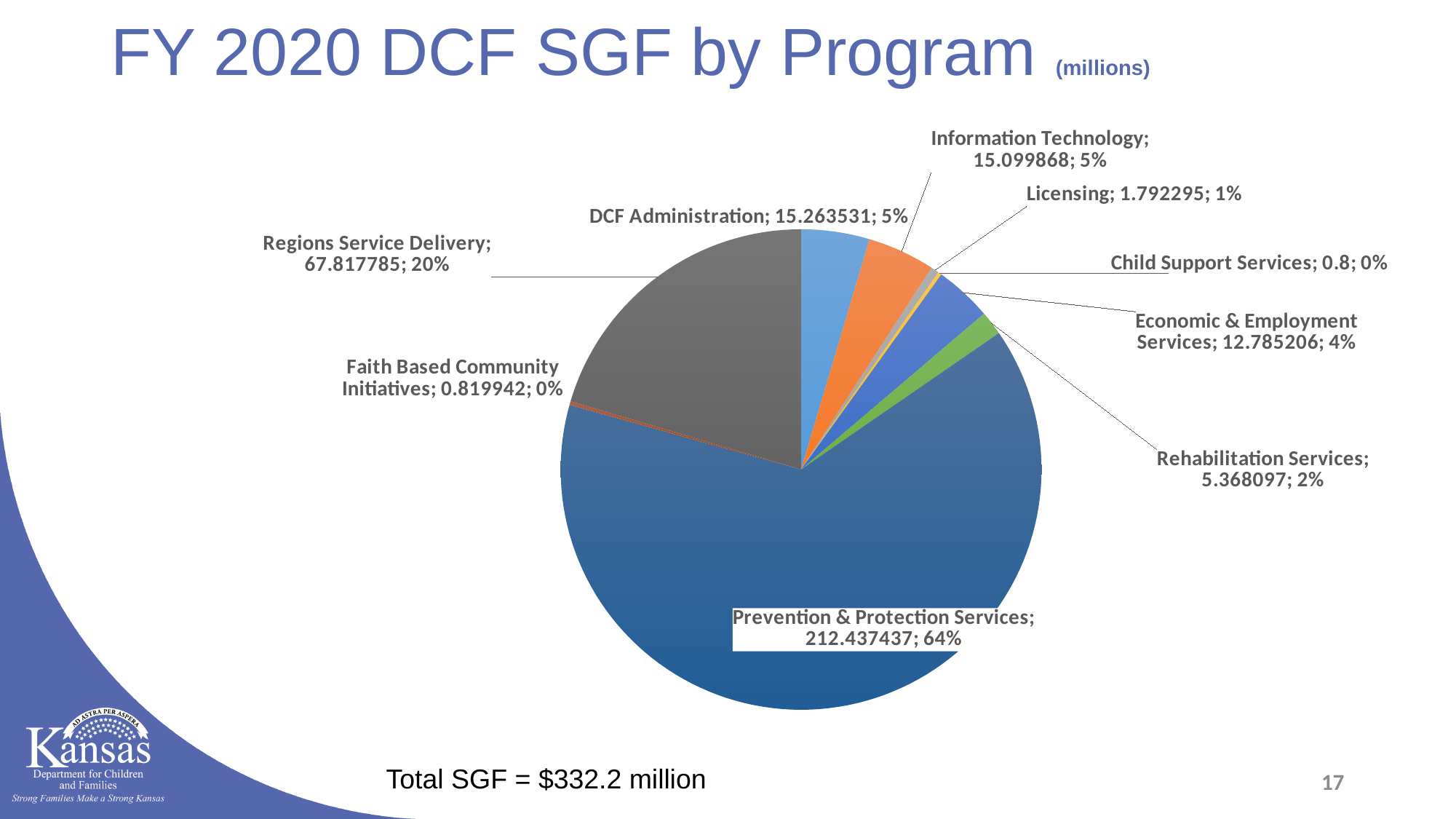
Which program has the largest slice of the pie? Prevention & Protection Services What is the value for Economic & Employment Services? 12.785206 Which is larger, the value for DCF Administration or the value for Information Technology? DCF Administration What is the difference between the values for Regions Service Delivery and Economic & Employment Services? 55.032579 What is the value for Licensing? 1.792295 What share of the pie does Rehabilitation Services represent? 2% What is the title of the chart on the slide? FY 2020 DCF SGF by Program (millions) How many programs are shown in the pie chart? 9 What is the value for Regions Service Delivery? 67.817785 What kind of chart is shown on the slide? Pie chart What is the value for Prevention & Protection Services? 212.437437 What share of the pie does Regions Service Delivery represent? 20%